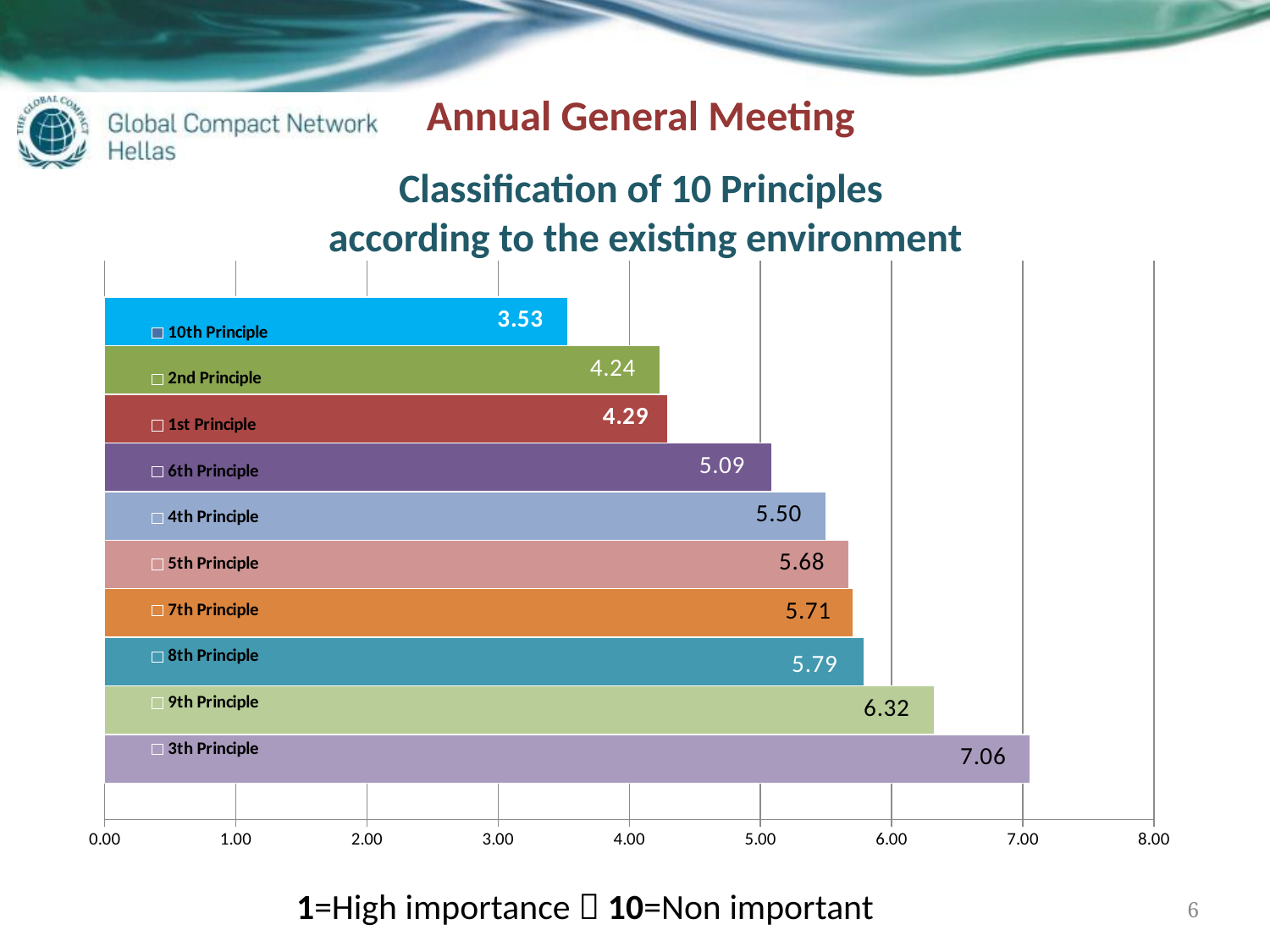
What is the value for the 3th Principle? 7.06 What is the value for the 9th Principle? 6.32 Which principle has the highest value? 3th Principle Which principle has the lowest value? 10th Principle How many principles are shown in the chart? 10 What is the value for the 10th Principle? 3.53 What kind of chart is shown on the slide? bar chart Is the value for the 9th Principle greater or less than 6.00? greater Which has a larger value, the 2nd Principle or the 6th Principle? 6th Principle What is the difference between the values for the 3th Principle and the 10th Principle? 3.53 What is the title of the chart? Classification of 10 Principles according to the existing environment What is the value for the 6th Principle? 5.09